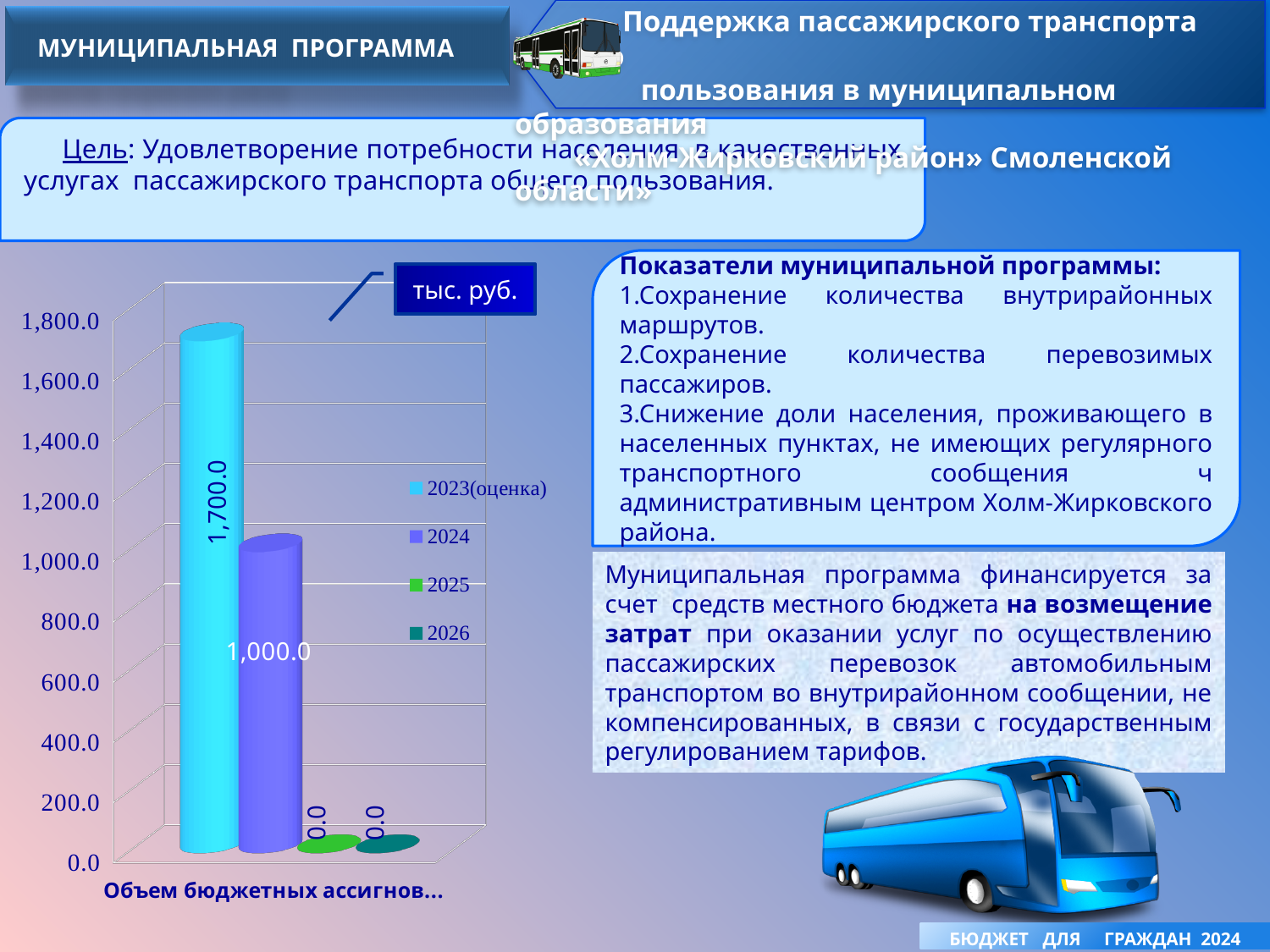
Is the value for 2024 greater or less than 1,200.0? less What is the value for 2023(оценка) in the chart? 1,700.0 What kind of chart is shown on the slide? bar chart What is the difference between the values for 2023(оценка) and 2024? 700.0 What is the value for 2024 in the chart? 1,000.0 How many series does the chart legend list? 4 What is the value for 2026 in the chart? 0.0 Which is larger, the value for 2023(оценка) or the value for 2024? 2023(оценка) Do the values rise or fall from 2023(оценка) to 2026? fall What is the value for 2025 in the chart? 0.0 Which series has the highest value in the chart? 2023(оценка) What unit is shown in the box above the chart? тыс. руб.